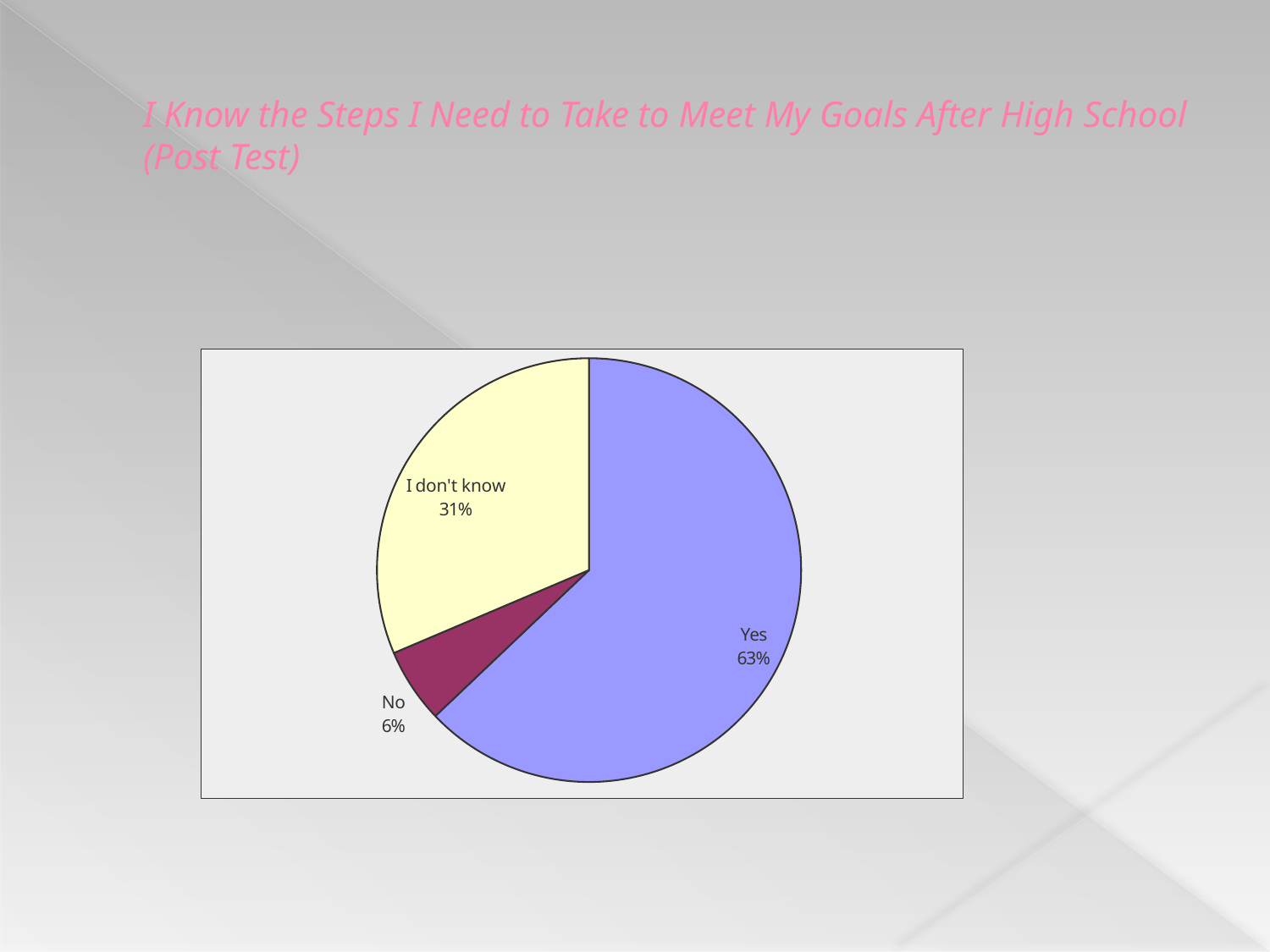
What is the difference in percentage points between the "I don't know" and "No" slices? 25 Which slice is larger, "No" or "I don't know"? I don't know Which response has the smallest share of the pie? No What colour is the "Yes" slice of the pie chart? blue/purple How many slices does the pie chart have? 3 What percentage of respondents answered "Yes"? 63% What percentage of respondents answered "I don't know"? 31% What kind of chart is shown on the slide? pie chart What is the title of the slide containing the pie chart? I Know the Steps I Need to Take to Meet My Goals After High School (Post Test) What is the difference in percentage points between the "Yes" and "I don't know" slices? 32 What percentage of respondents answered "No"? 6% Which response has the largest share of the pie? Yes